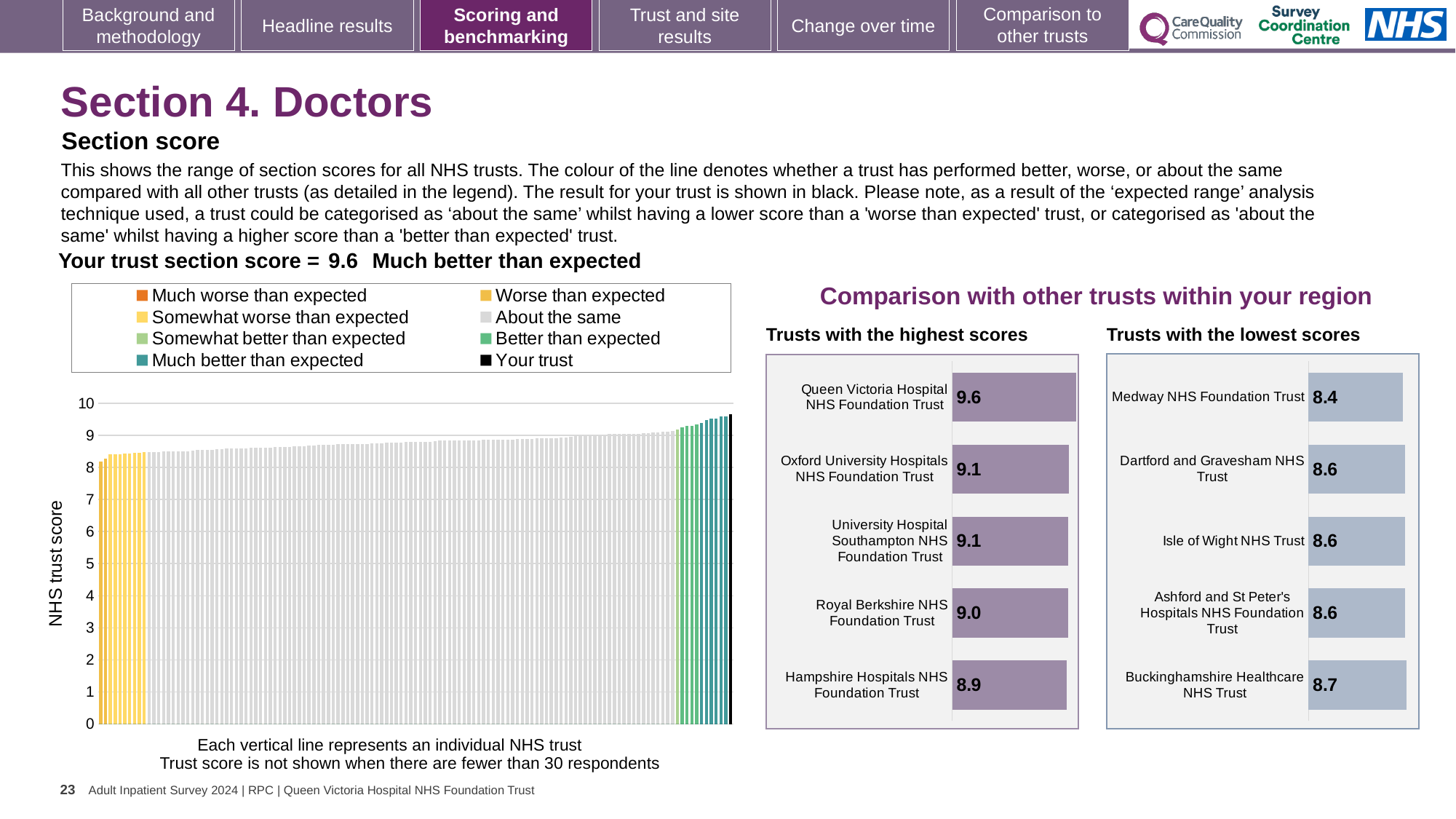
In the 'Trusts with the highest scores' chart, which trust has the highest score? Queen Victoria Hospital NHS Foundation Trust In the 'Trusts with the highest scores' chart, what is the score for Hampshire Hospitals NHS Foundation Trust? 8.9 In the 'Trusts with the highest scores' chart, what is the difference between the scores of Queen Victoria Hospital NHS Foundation Trust and Royal Berkshire NHS Foundation Trust? 0.6 In the 'Trusts with the lowest scores' chart, what is the score for Medway NHS Foundation Trust? 8.4 In the 'Trusts with the lowest scores' chart, which trust has the lowest score? Medway NHS Foundation Trust How many entries does the legend of the NHS trust score chart on the left list? 8 In the 'Trusts with the lowest scores' chart, what is the score for Buckinghamshire Healthcare NHS Trust? 8.7 In the 'Trusts with the highest scores' chart, what is the score for Queen Victoria Hospital NHS Foundation Trust? 9.6 In the 'Trusts with the lowest scores' chart, what is the difference between the scores of Buckinghamshire Healthcare NHS Trust and Medway NHS Foundation Trust? 0.3 How many trusts are shown in the 'Trusts with the highest scores' chart? 5 Which is larger: the score for Oxford University Hospitals NHS Foundation Trust in the highest scores chart or the score for Dartford and Gravesham NHS Trust in the lowest scores chart? Oxford University Hospitals NHS Foundation Trust In the NHS trust score chart on the left, do the values rise or fall from left to right along the x axis? rise